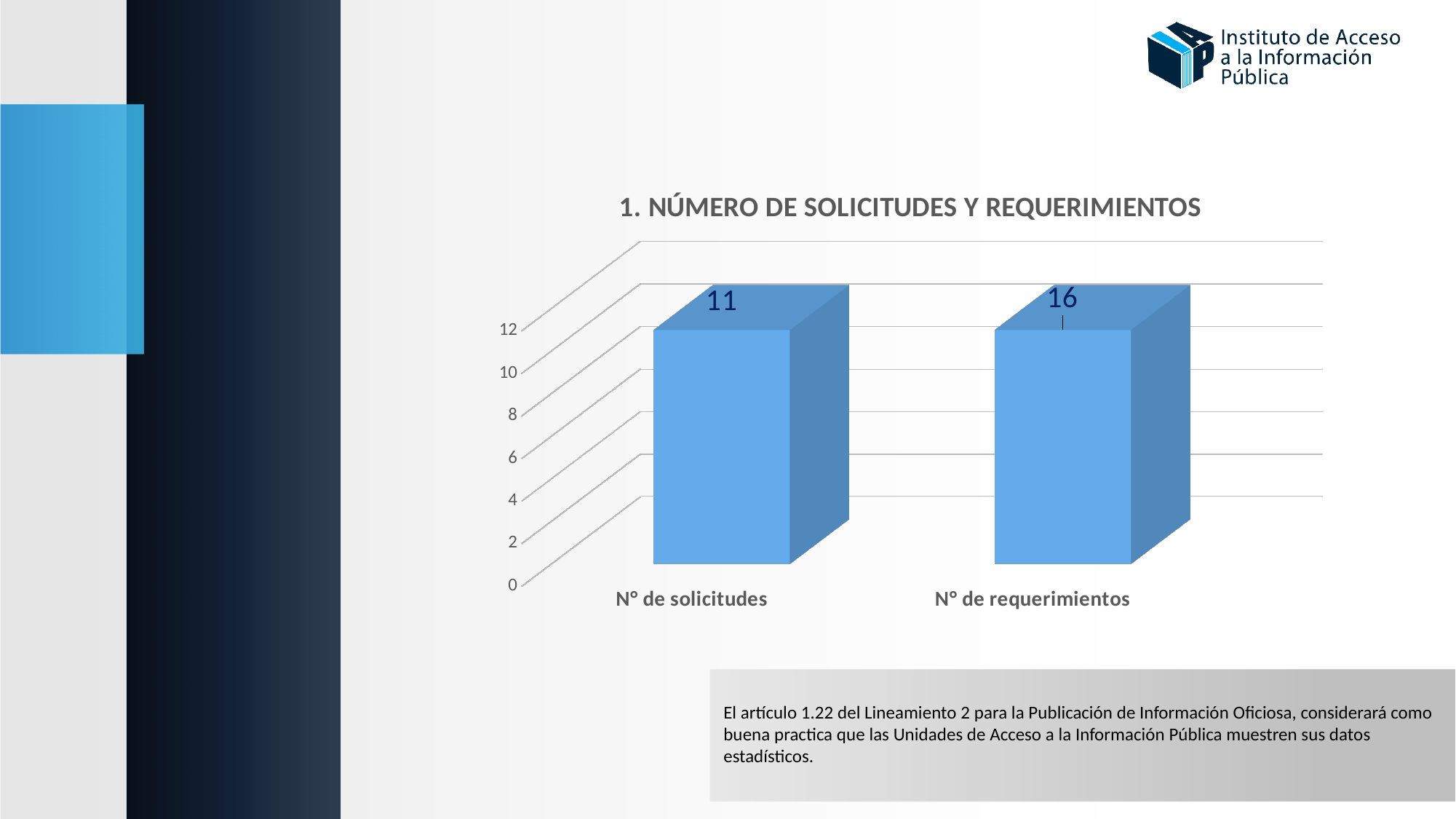
What is the difference between N° de requerimientos and N° de solicitudes? 5 What is the value for N° de requerimientos? 16 What is the title of the chart? 1. NÚMERO DE SOLICITUDES Y REQUERIMIENTOS Is the value for N° de solicitudes greater or less than 10? greater What is the highest tick value shown on the vertical axis? 12 Which category has the highest value? N° de requerimientos What is the value for N° de solicitudes? 11 Which is larger, N° de solicitudes or N° de requerimientos? N° de requerimientos What kind of chart is shown on the slide? bar chart How many categories are shown in the chart? 2 Which category has the lowest value? N° de solicitudes